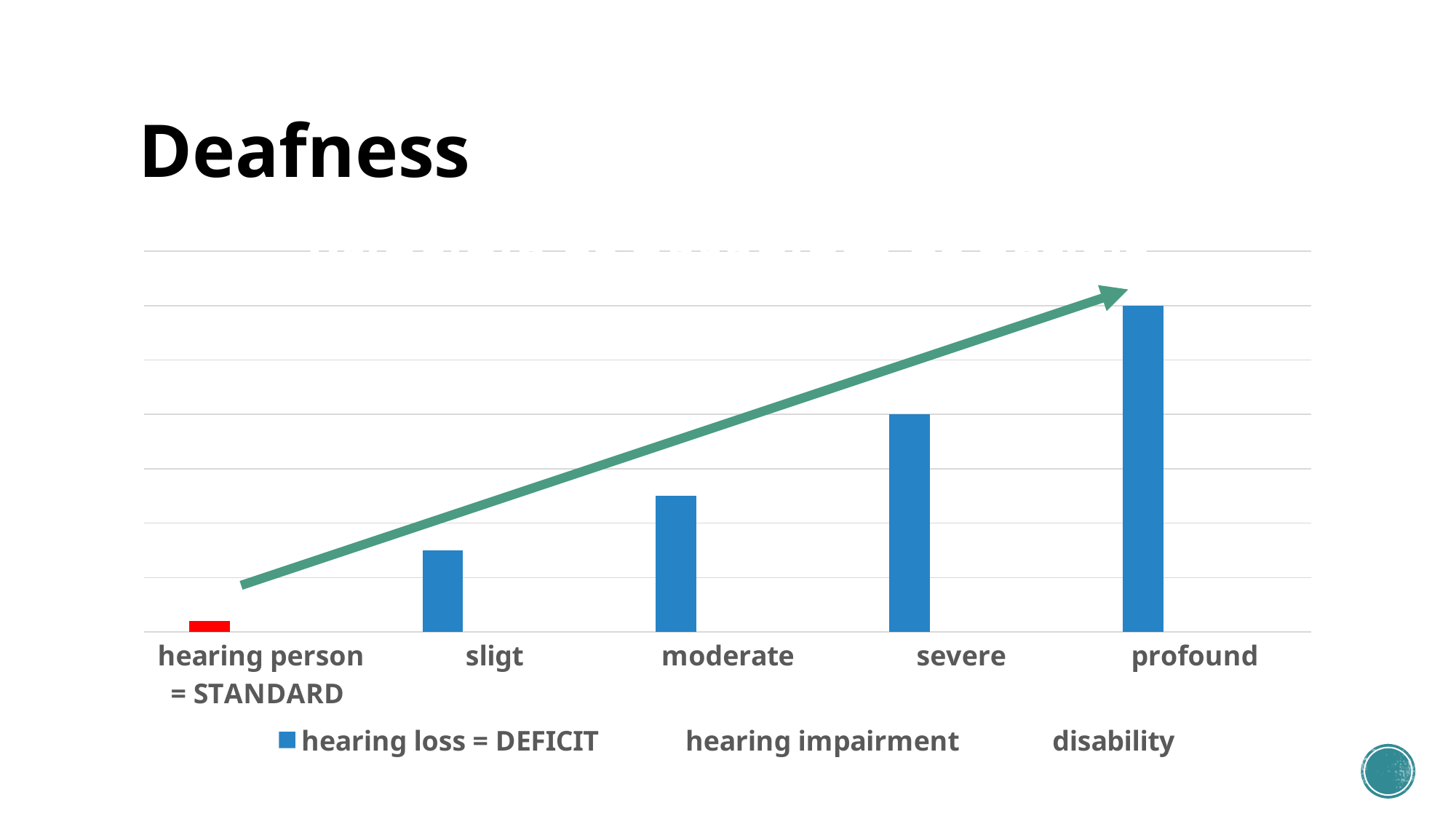
What is the title of the slide containing the chart? Deafness Which bar is taller, sligt or profound? profound Which category has the tallest bar? profound Which bar is taller, hearing person = STANDARD or sligt? sligt What kind of chart is shown on the slide? bar chart What colour is the bar for hearing person = STANDARD? red Do the bar heights rise or fall from left to right along the x axis? rise Which bar is taller, severe or moderate? severe How many categories are shown on the x axis of the chart? 5 Which category has the shortest bar? hearing person = STANDARD